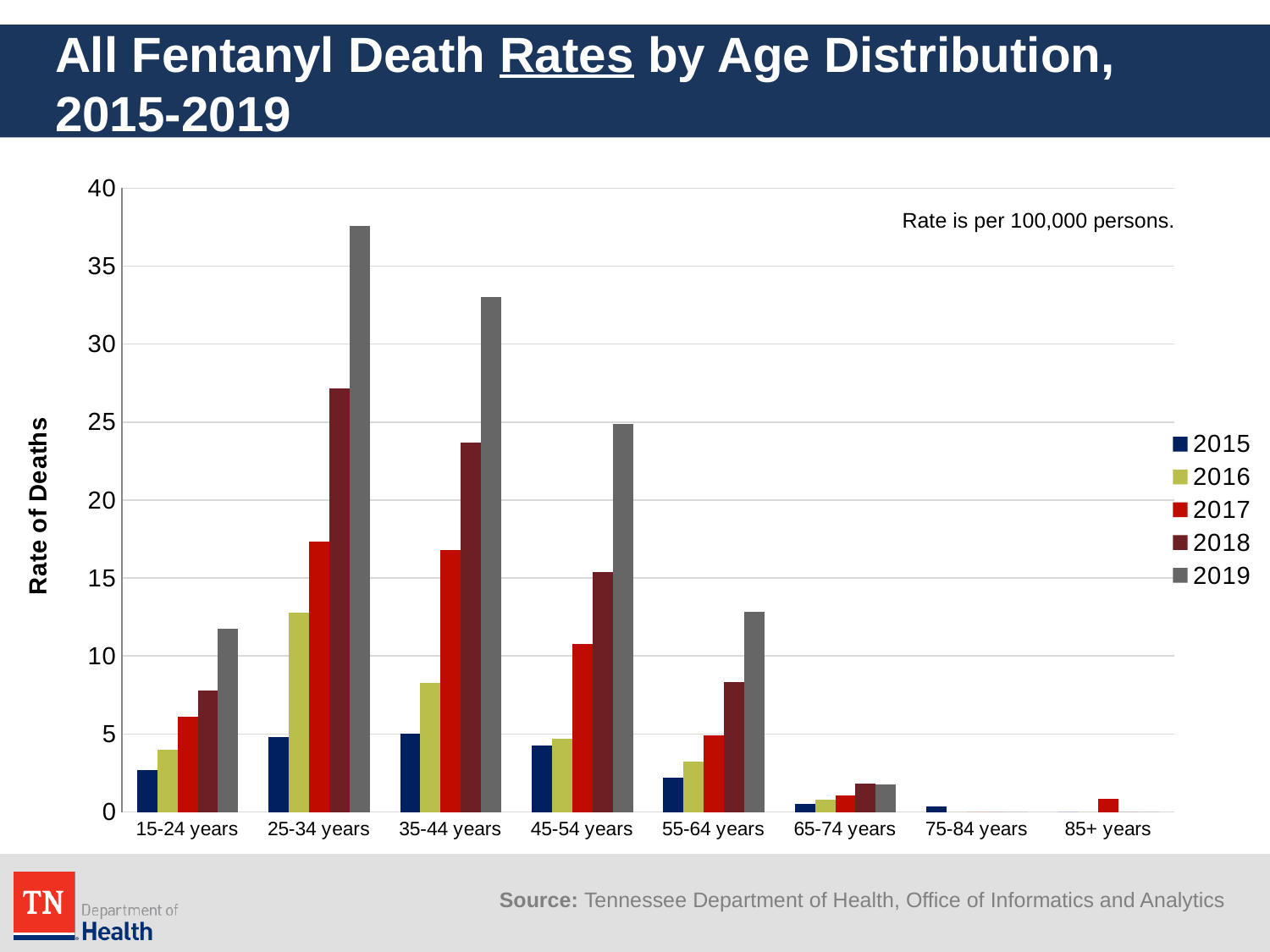
Which is larger, the 2019 value for 45-54 years or the 2019 value for 55-64 years? 45-54 years What kind of chart is shown on the slide? bar chart What is the title of the y axis? Rate of Deaths Which age group has the highest 2019 fentanyl death rate? 25-34 years Is the 2016 value for 25-34 years greater or less than 10? greater How many age groups are shown on the x axis? 8 According to the note on the chart, the rate is per how many persons? 100,000 persons Is the 2018 value for 25-34 years greater or less than 25? greater For the 25-34 years age group, do the rates rise or fall from 2015 to 2019? rise How many series does the legend list? 5 Is the 2019 value for 25-34 years greater or less than 35? greater